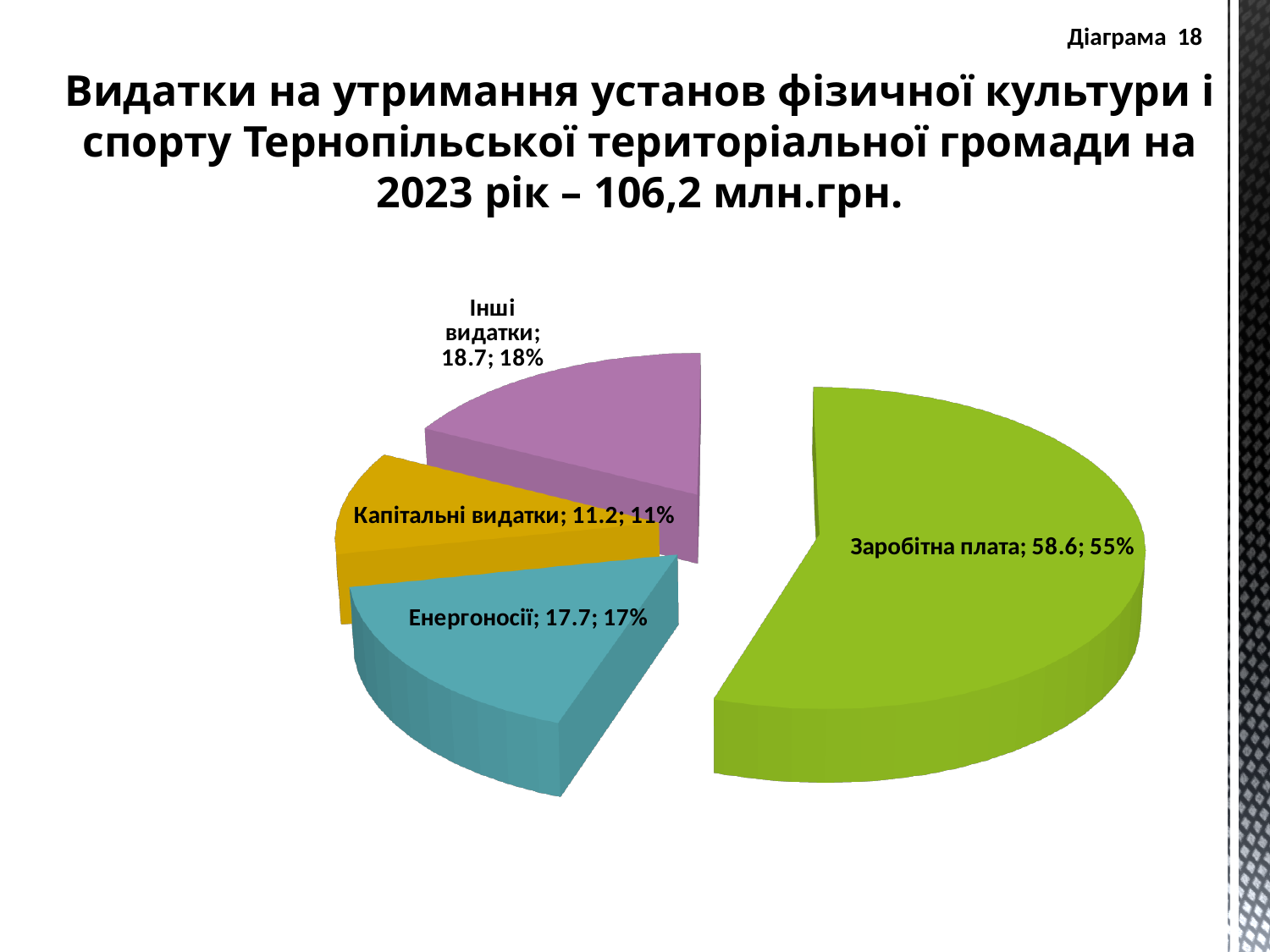
What value is shown for Енергоносії on the pie chart? 17.7 How many slices does the pie chart have? 4 Which category has the smallest slice of the pie? Капітальні видатки What value is shown for Капітальні видатки on the pie chart? 11.2 What share of the pie does Заробітна плата represent? 55% What value is shown for Інші видатки on the pie chart? 18.7 What is the difference between the values for Заробітна плата and Енергоносії? 40.9 Which category has the largest slice of the pie? Заробітна плата Which is larger, the value for Інші видатки or the value for Капітальні видатки? Інші видатки What share of the pie does Енергоносії represent? 17% What value is shown for Заробітна плата on the pie chart? 58.6 What kind of chart is shown on the slide? Pie chart